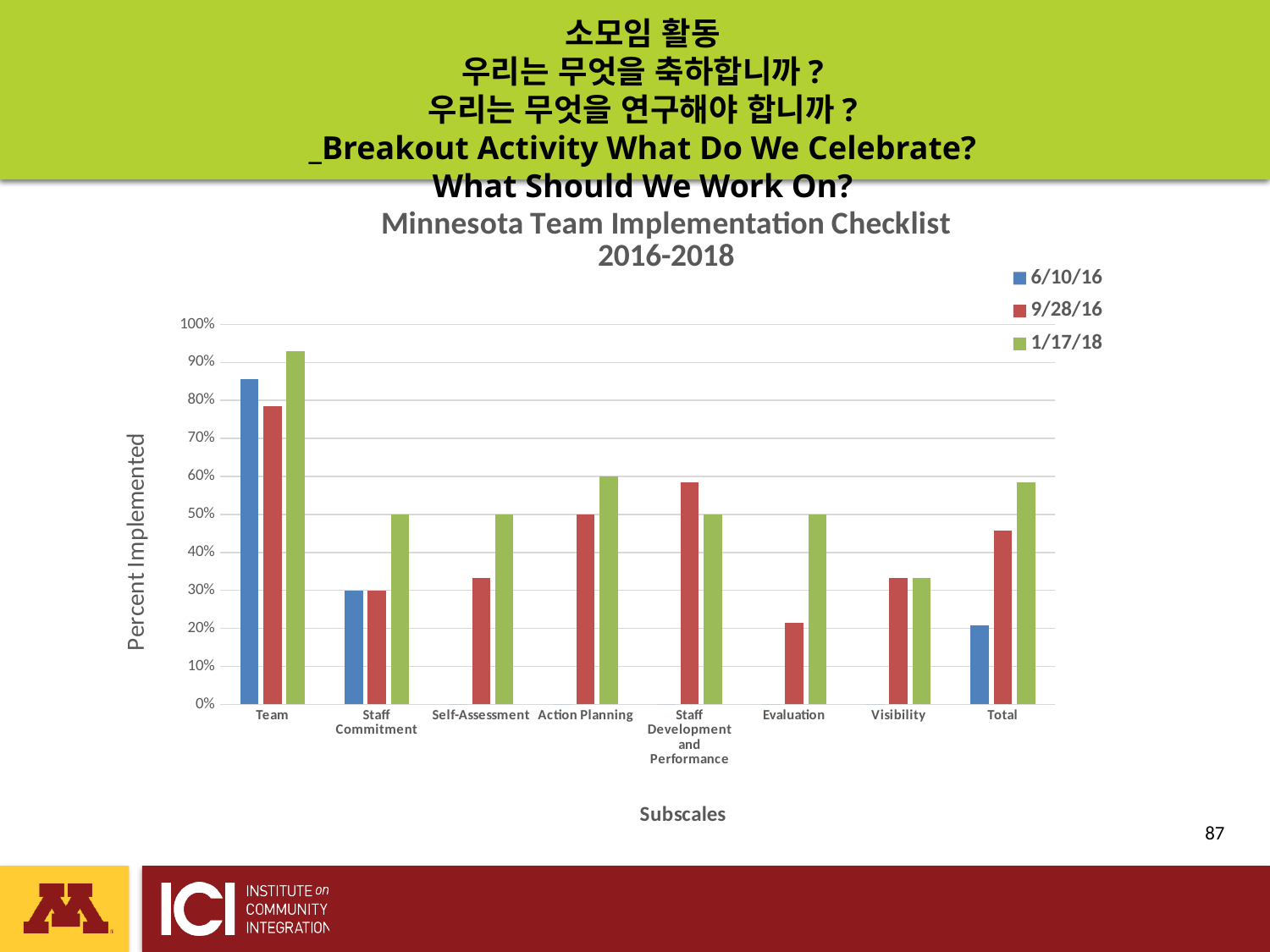
For Total, which series has the larger value, 9/28/16 or 1/17/18? 1/17/18 How many series does the legend list? 3 What is the title of the chart? Minnesota Team Implementation Checklist 2016-2018 Is the 6/10/16 value for Team greater or less than 80%? greater Which category has the highest value for the 1/17/18 series? Team Is the 6/10/16 value for Total greater or less than 30%? less For Staff Development and Performance, which series has the larger value, 9/28/16 or 1/17/18? 9/28/16 What kind of chart is shown on the slide? bar chart What is the 1/17/18 value for Action Planning? 60% What is the title of the vertical axis? Percent Implemented How many subscale categories are shown along the x axis? 8 Which category has the lowest value for the 9/28/16 series? Evaluation